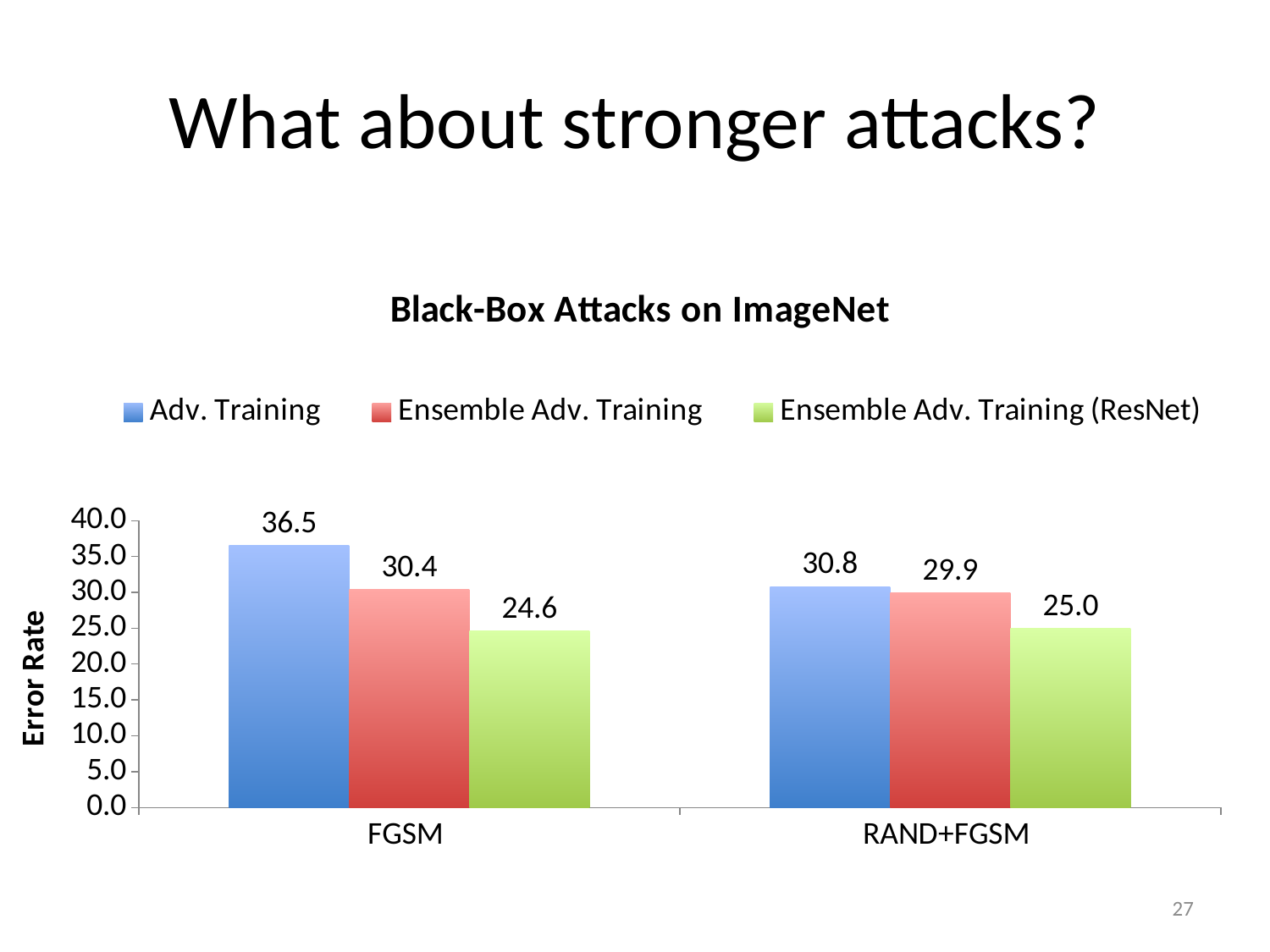
What is the error rate for Adv. Training under the FGSM attack? 36.5 What is the difference between the Adv. Training error rates for FGSM and RAND+FGSM? 5.7 Which series has the highest error rate under the FGSM attack? Adv. Training What is the error rate for Ensemble Adv. Training under the FGSM attack? 30.4 Which is larger: the Ensemble Adv. Training (ResNet) error rate for FGSM or for RAND+FGSM? RAND+FGSM How many attack categories are shown on the x axis? 2 What kind of chart is shown on the slide? Bar chart What is the title of the chart? Black-Box Attacks on ImageNet How many series does the legend list? 3 What is the difference between the Adv. Training and Ensemble Adv. Training error rates under FGSM? 6.1 What is the error rate for Ensemble Adv. Training (ResNet) under the RAND+FGSM attack? 25.0 Which series has the lowest error rate under the RAND+FGSM attack? Ensemble Adv. Training (ResNet)